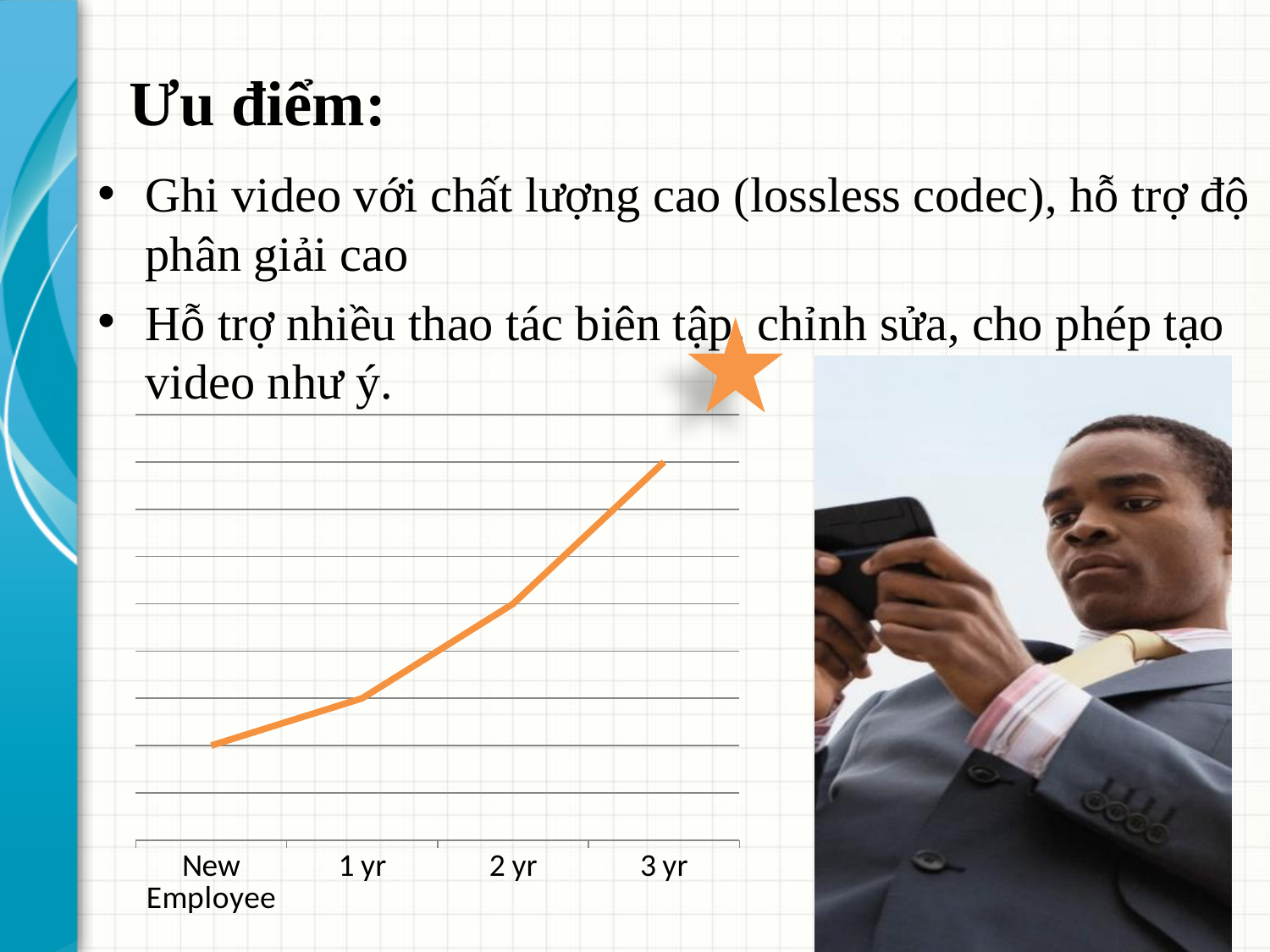
Do the values in the chart rise or fall from New Employee to 3 yr? rise How many categories are shown on the x axis of the chart? 4 Which is larger in the chart, the value for New Employee or the value for 3 yr? 3 yr Which category has the highest value in the chart? 3 yr What is the first category label on the x axis of the chart? New Employee What colour is the line in the chart? orange What kind of chart is shown on the slide? line chart Which is larger in the chart, the value for 1 yr or the value for 2 yr? 2 yr Which category has the lowest value in the chart? New Employee